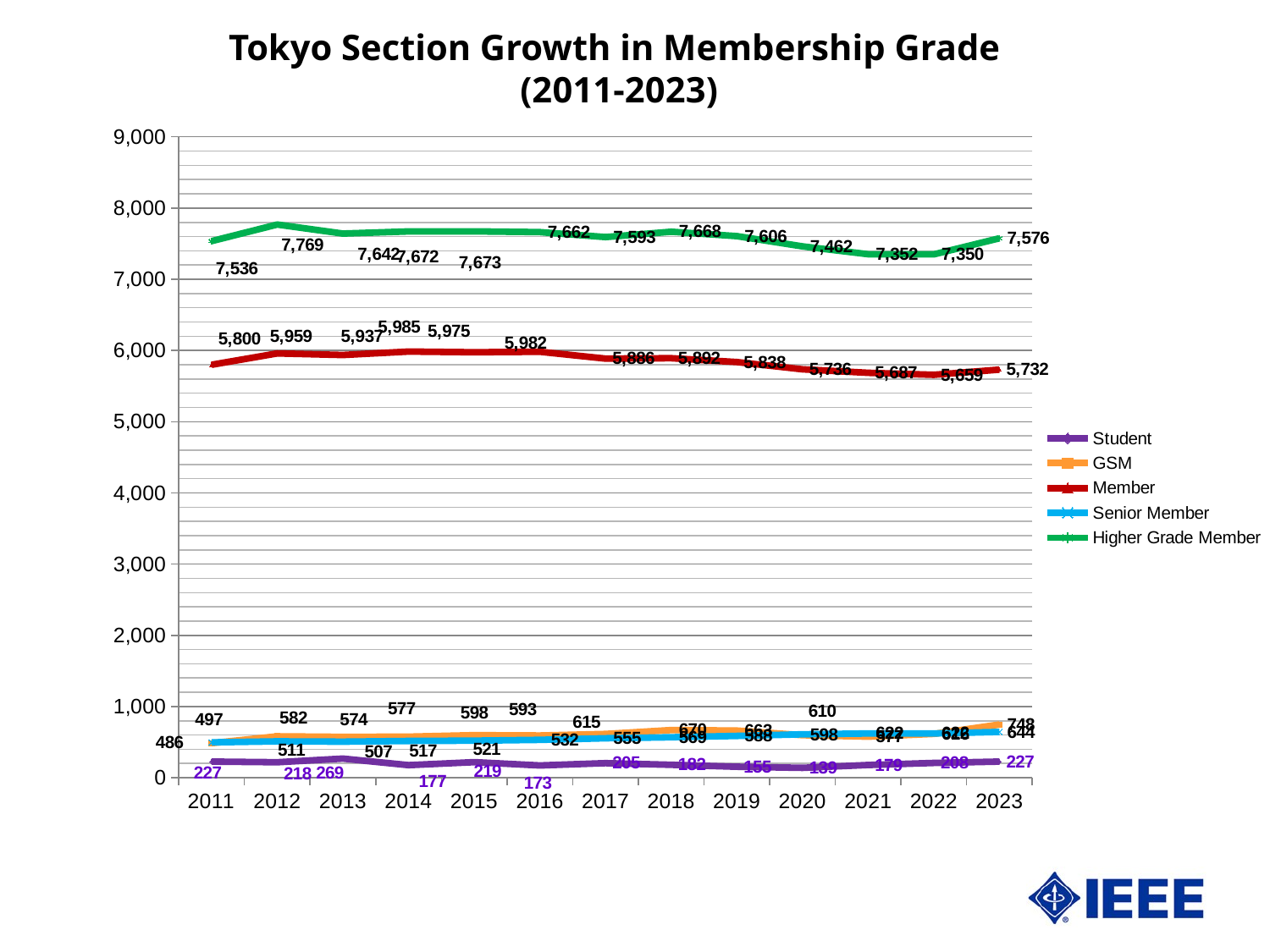
What is the GSM value for 2023? 748 In which year is the Student value highest? 2013 How many series does the legend list? 5 What is the difference between the Higher Grade Member values for 2012 and 2011? 233 How many years are plotted along the x axis? 13 What is the Higher Grade Member value for 2012? 7,769 Which year has the larger Member value, 2011 or 2023? 2011 In which year is the Student value lowest? 2020 Does the Higher Grade Member line rise or fall from 2019 to 2022? fall What kind of chart is shown on the slide? line chart Is the Member value for 2016 greater or less than 5,000? greater In which year is the Higher Grade Member value highest? 2012